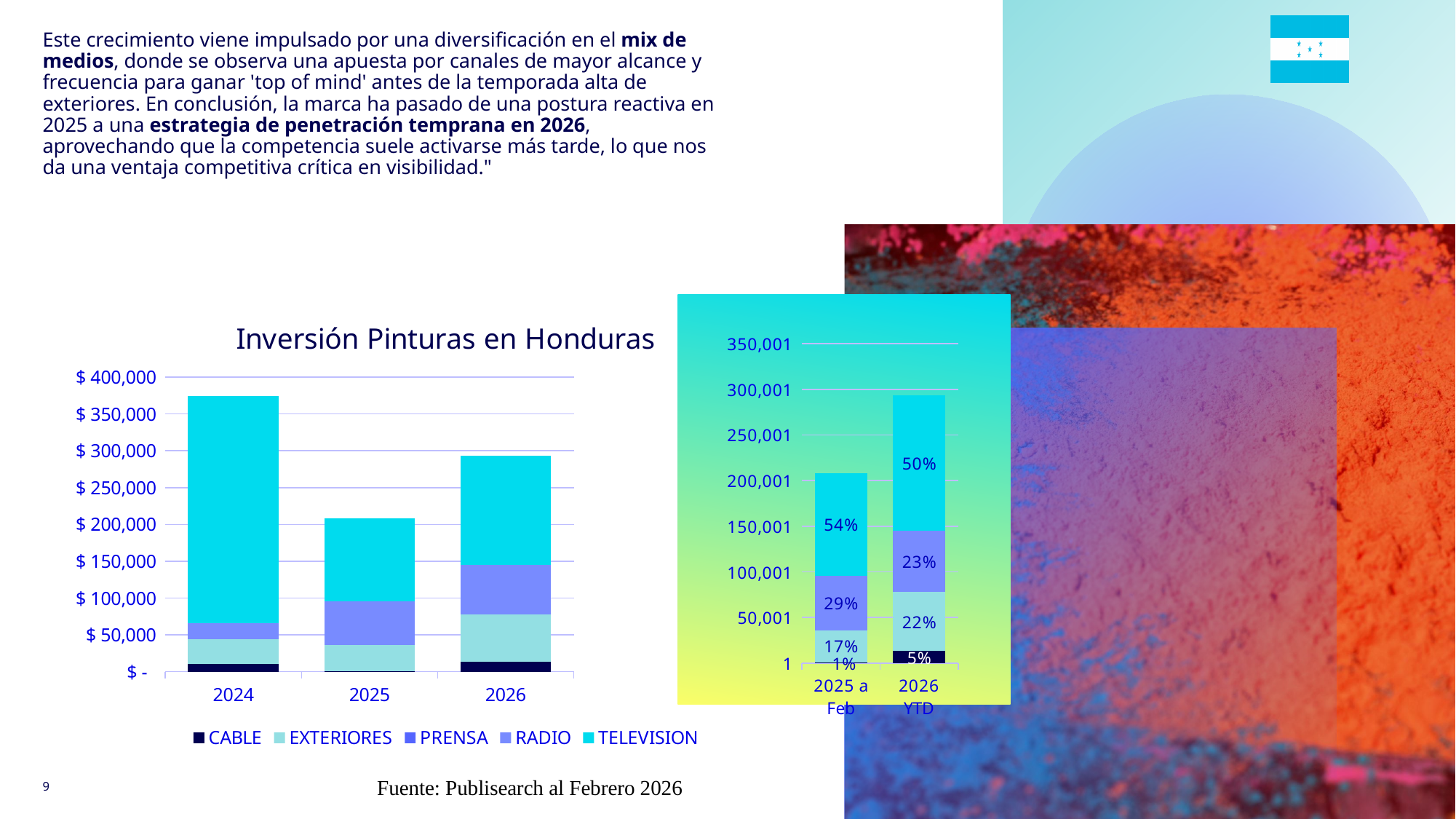
In 'Inversión Pinturas en Honduras', is the total for 2026 greater or less than $ 250,000? greater In 'Inversión Pinturas en Honduras', is the total for 2024 greater or less than $ 350,000? greater In 'Inversión Pinturas en Honduras', which series is listed first in the legend? CABLE What type of chart is 'Inversión Pinturas en Honduras'? stacked bar chart How many series does the legend of 'Inversión Pinturas en Honduras' list? 5 In the chart on the right of the slide, what is the smallest percentage label in the '2025 a Feb' bar? 1% How many years are shown on the x axis of 'Inversión Pinturas en Honduras'? 3 In the chart on the right of the slide, how many bars are shown? 2 In 'Inversión Pinturas en Honduras', is the total for 2025 greater or less than $ 250,000? less In the chart on the right of the slide, what is the largest percentage label in the '2026 YTD' bar? 50% In 'Inversión Pinturas en Honduras', which year has the highest total bar? 2024 In 'Inversión Pinturas en Honduras', which year has the lowest total bar? 2025